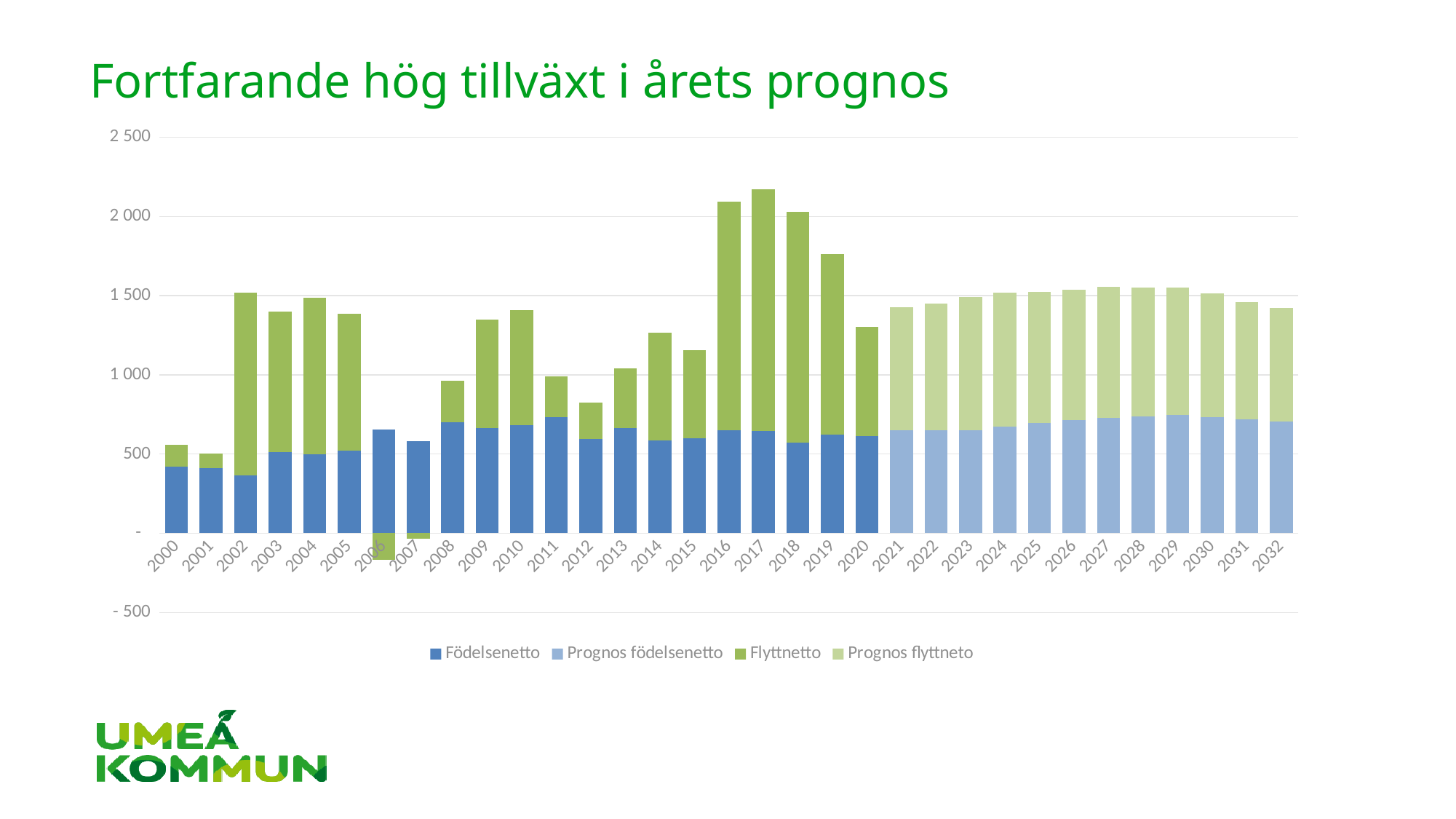
What is the title of the slide? Fortfarande hög tillväxt i årets prognos Is the total stacked bar for 2012 greater or less than 1 000? less What kind of chart is shown on the slide? Stacked bar chart How many series does the legend list? 4 How many years are shown along the x axis? 33 Which year has the tallest stacked bar? 2017 Which total stacked bar is taller, 2017 or 2020? 2017 Which total stacked bar is taller, 2001 or 2002? 2002 Is the Flyttnetto value for 2006 greater or less than 0? less Which series is shown in dark blue according to the legend? Födelsenetto Is the total stacked bar for 2020 greater or less than 1 000? greater